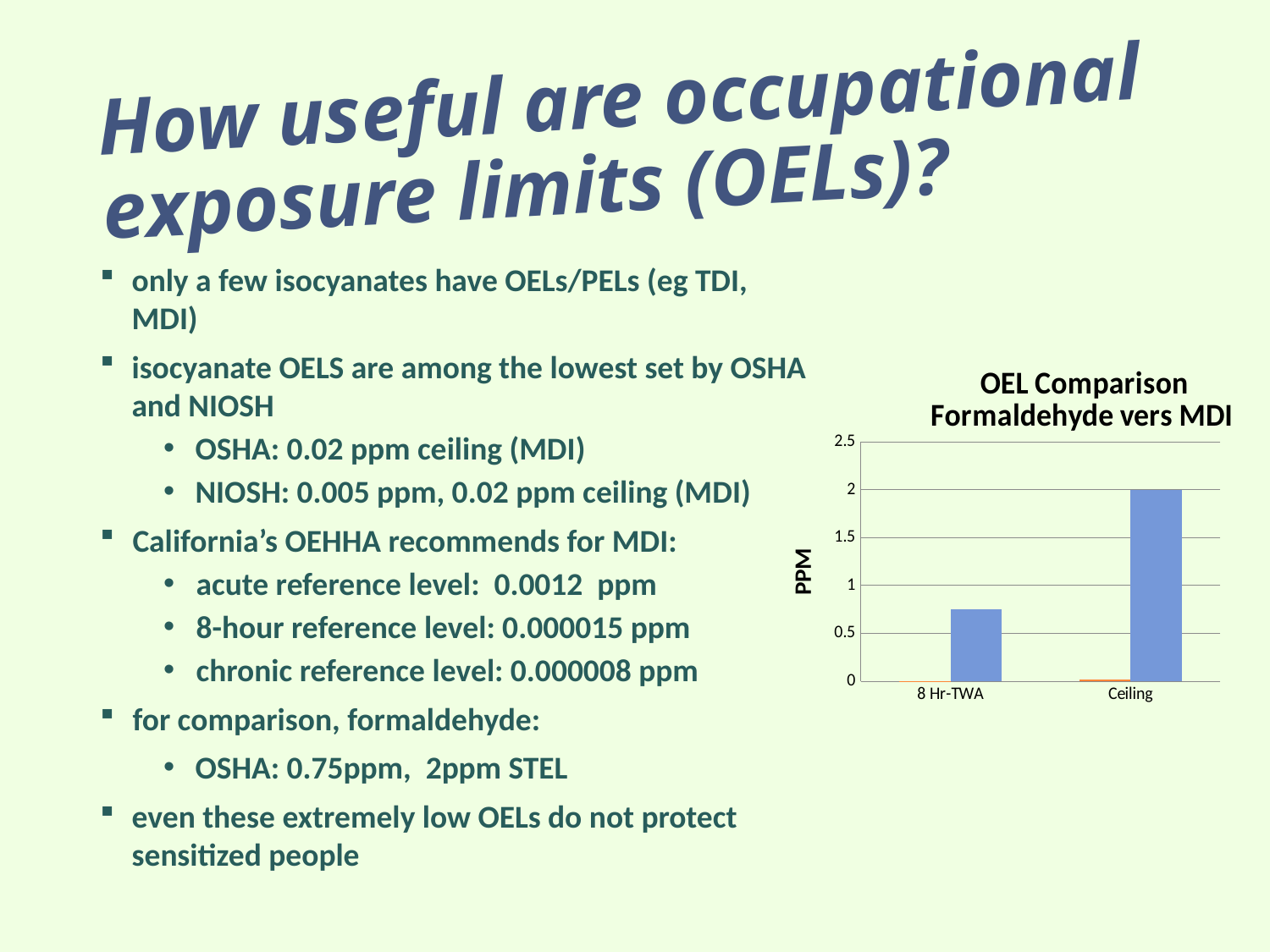
Which category has the highest blue bar? Ceiling Which category has the lowest blue bar? 8 Hr-TWA What is the label on the vertical axis of the chart? PPM Which blue bar is larger, 8 Hr-TWA or Ceiling? Ceiling What value does the tall blue bar for Ceiling reach on the PPM axis? 2 What is the highest value shown on the PPM axis? 2.5 Do the blue bars rise or fall from 8 Hr-TWA to Ceiling? rise What is the title of the chart? OEL Comparison Formaldehyde vers MDI What kind of chart is shown on the slide? bar chart Is the blue bar for 8 Hr-TWA greater or less than 0.5? greater Is the blue bar for 8 Hr-TWA greater or less than 1? less How many categories are shown on the x axis of the chart? 2